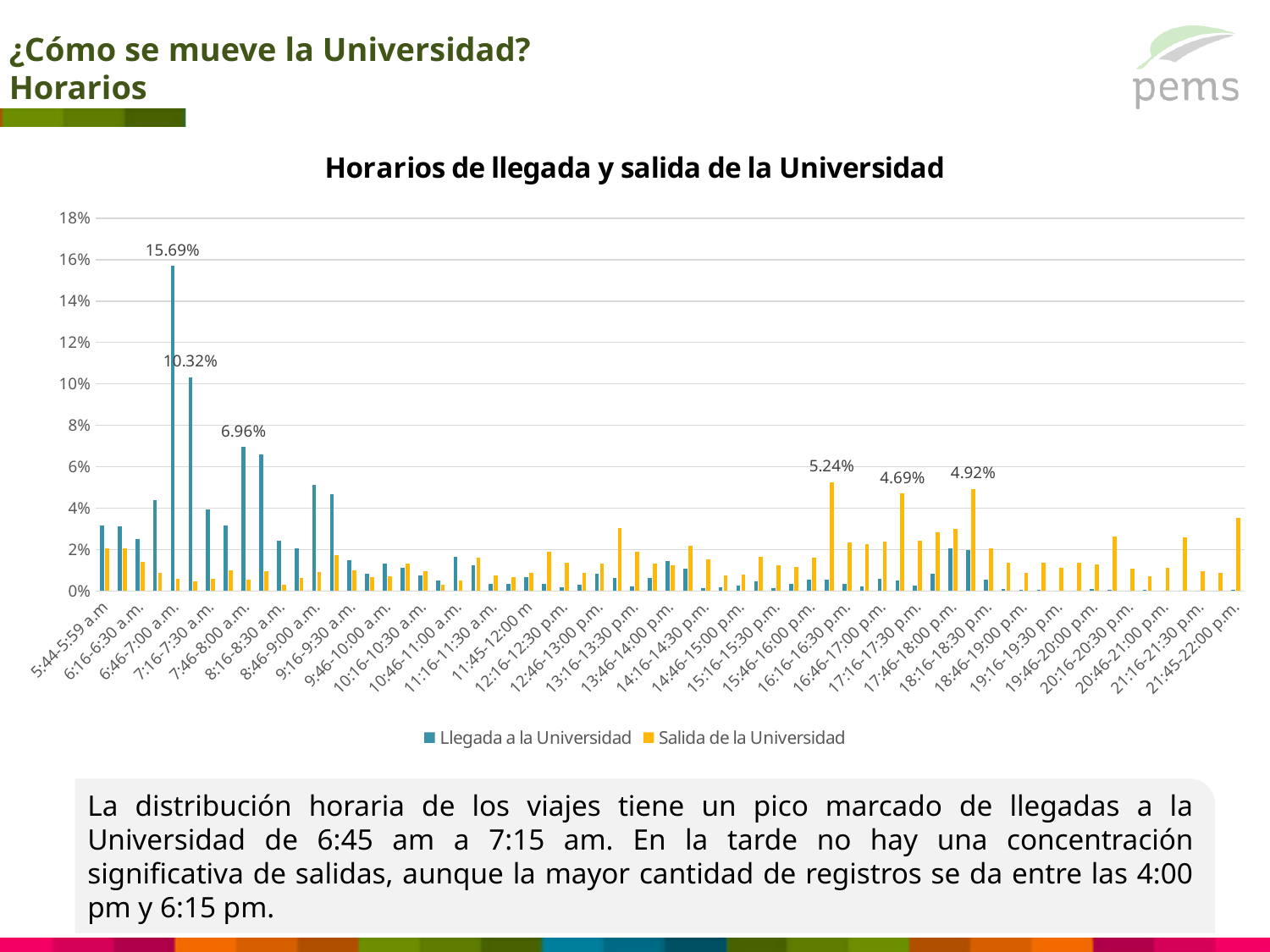
What is the highest labeled value for the Salida de la Universidad series? 5.24% Which is larger, the labeled Salida value 4.69% or the labeled Salida value 4.92%? 4.92% Which series contains the tallest bar in the chart, Llegada a la Universidad or Salida de la Universidad? Llegada a la Universidad Is the tallest Llegada a la Universidad bar greater or less than 14%? greater What is the difference between the labeled Llegada values 15.69% and 6.96%? 8.73% What are the two series named in the legend? Llegada a la Universidad and Salida de la Universidad What is the difference between the labeled Salida values 5.24% and 4.92%? 0.32% What is the highest value shown for the Llegada a la Universidad series? 15.69% What is the difference between the two highest labeled values of the Llegada a la Universidad series, 15.69% and 10.32%? 5.37% What is the title of the chart? Horarios de llegada y salida de la Universidad How many series does the legend list? 2 What kind of chart is shown on the slide? bar chart